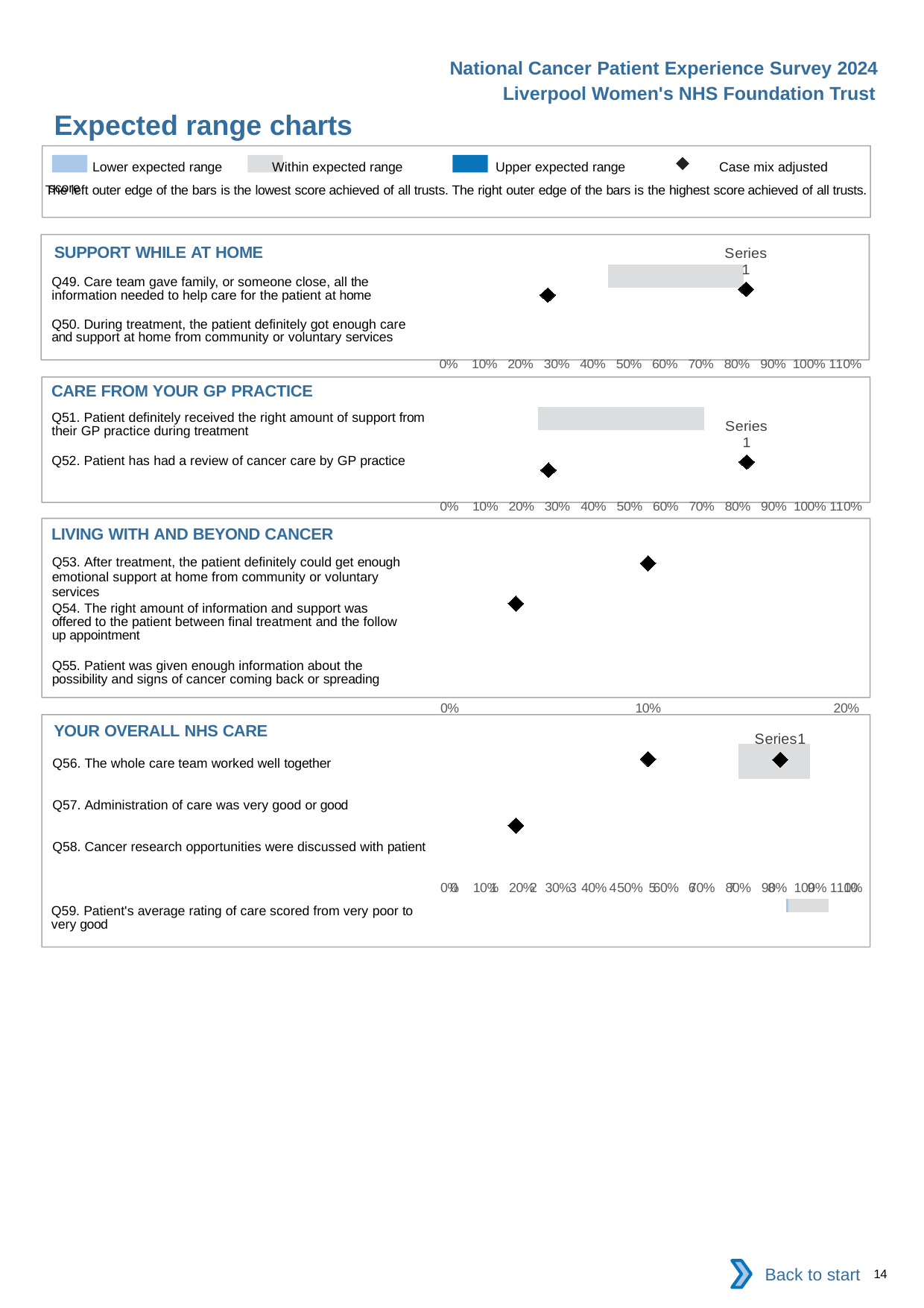
In the LIVING WITH AND BEYOND CANCER chart, is the diamond marker on the Q54 row greater or less than 10%? less What is the highest tick shown on the x axis of the LIVING WITH AND BEYOND CANCER chart? 20% How many questions are listed in the LIVING WITH AND BEYOND CANCER chart? 3 What kind of chart is used in the SUPPORT WHILE AT HOME section? bar chart How many questions are listed in the YOUR OVERALL NHS CARE chart? 4 According to the legend, what does the black diamond marker represent? Case mix adjusted score According to the legend, what colour is used for 'Within expected range'? grey In the YOUR OVERALL NHS CARE chart, is the leftmost diamond marker greater or less than 30%? less In the SUPPORT WHILE AT HOME chart, is the leftmost diamond marker greater or less than 40%? less What is the highest tick shown on the x axis of the SUPPORT WHILE AT HOME chart? 110% How many entries does the legend at the top of the slide list? 4